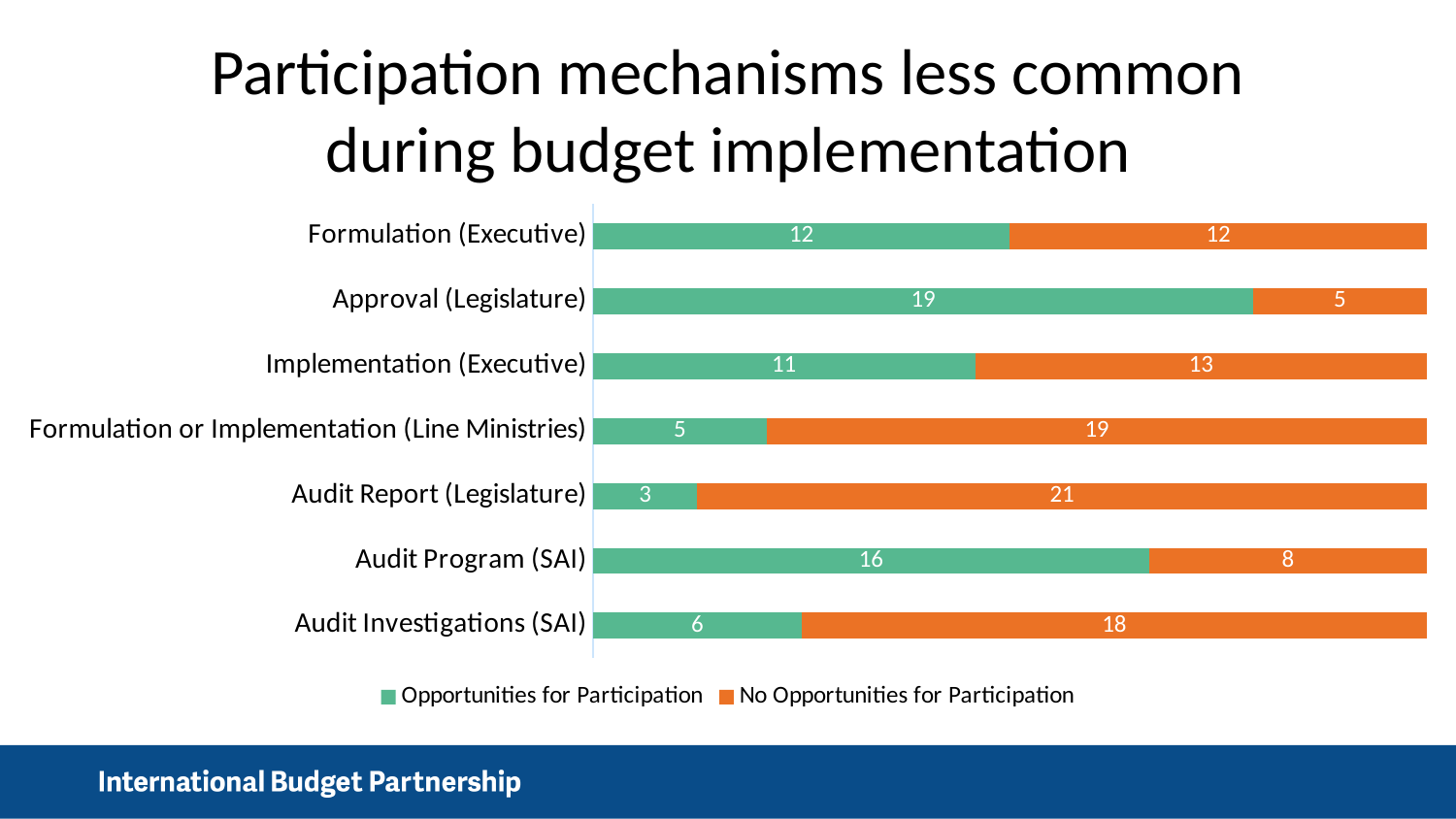
What kind of chart is shown on the slide? Stacked bar chart What is the value of No Opportunities for Participation for Audit Report (Legislature)? 21 How many categories are shown on the chart? 7 How many series does the legend list? 2 Which is larger for Implementation (Executive): Opportunities for Participation or No Opportunities for Participation? No Opportunities for Participation Which category has the highest value for Opportunities for Participation? Approval (Legislature) What colour represents No Opportunities for Participation in the chart? Orange What is the value of Opportunities for Participation for Audit Investigations (SAI)? 6 What is the difference between No Opportunities for Participation and Opportunities for Participation for Audit Program (SAI)? 8 What is the total of the stacked bar for Formulation or Implementation (Line Ministries)? 24 What is the value of Opportunities for Participation for Approval (Legislature)? 19 Which category has the lowest value for Opportunities for Participation? Audit Report (Legislature)